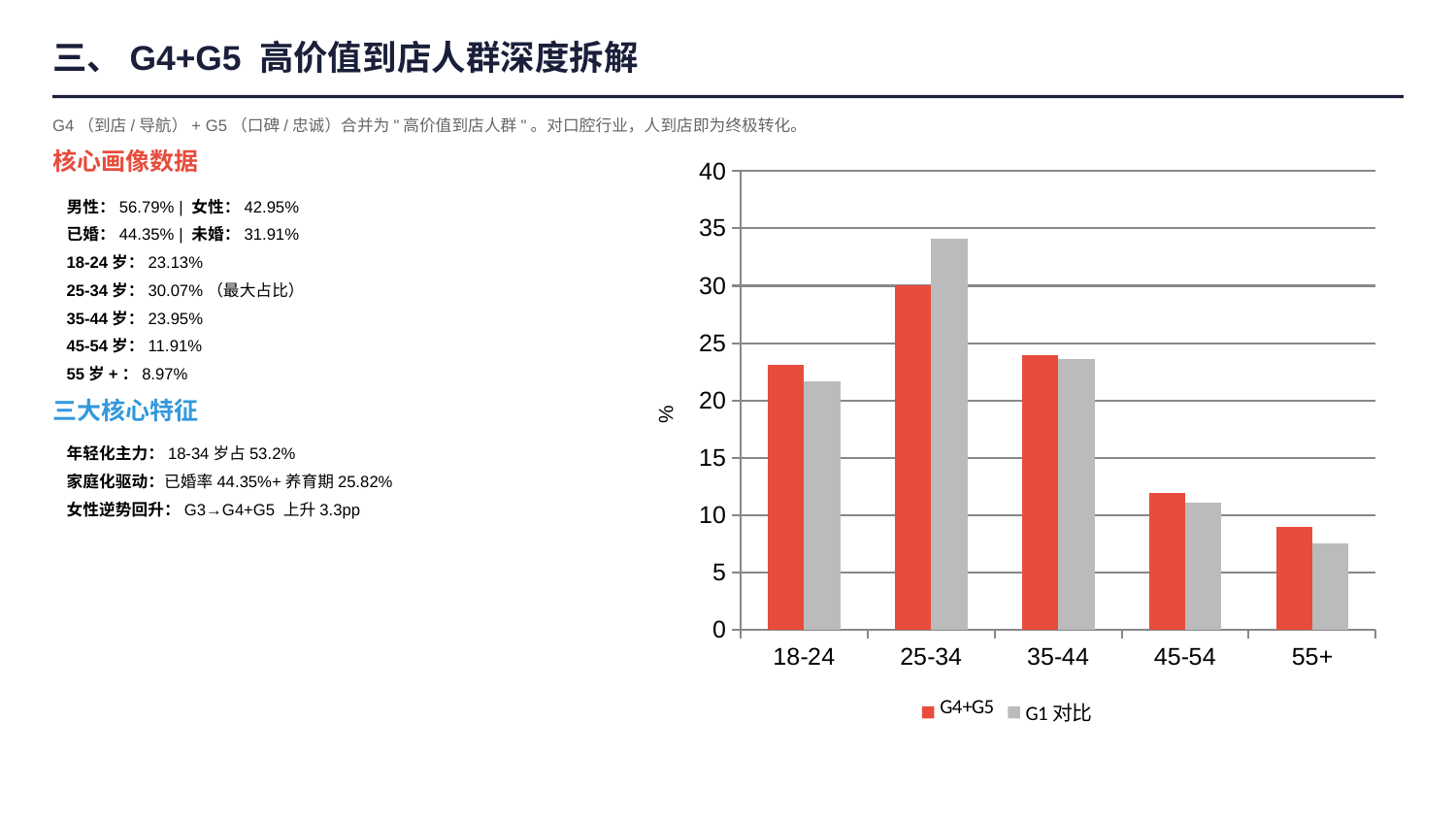
Which age group has the highest G4+G5 value in the chart? 25-34 For the 25-34 age group, which series has the larger value, G4+G5 or G1 对比? G1 对比 Which age group has the lowest G1 对比 value in the chart? 55+ How many age groups are shown on the x axis of the chart? 5 Is the G1 对比 value for 25-34 greater or less than 30? greater What label is shown on the y axis of the chart? % Do the G4+G5 values rise or fall from the 25-34 group to the 55+ group? fall What kind of chart is shown on the slide? bar chart Is the G4+G5 value for 55+ greater or less than 10? less For the 18-24 age group, which series has the larger value, G4+G5 or G1 对比? G4+G5 Is the G4+G5 value for 45-54 greater or less than 10? greater How many series does the chart legend list? 2